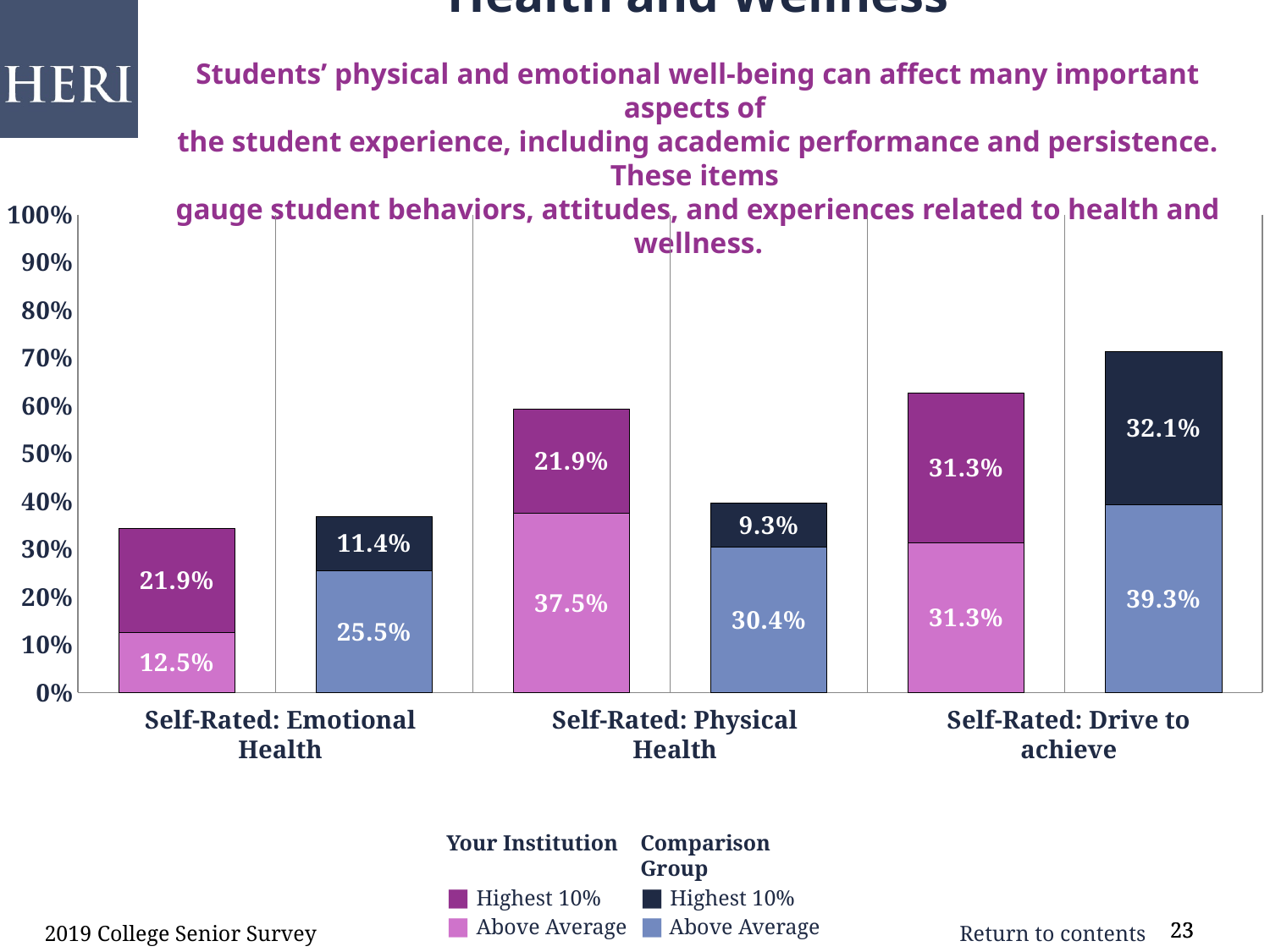
What is the total of the stacked bar for the Comparison Group on Self-Rated: Drive to achieve? 71.4% Which category has the tallest stacked bar for the Comparison Group? Self-Rated: Drive to achieve Is the total stacked bar for Your Institution on Self-Rated: Emotional Health greater or less than 40%? less How many entries does the legend list? 4 What is the "Highest 10%" value for Your Institution on Self-Rated: Drive to achieve? 31.3% What kind of chart is shown on the slide? Stacked bar chart What is the difference between the "Above Average" values for Your Institution and the Comparison Group on Self-Rated: Physical Health? 7.1% What is the "Highest 10%" value for the Comparison Group on Self-Rated: Physical Health? 9.3% What is the "Above Average" value for the Comparison Group on Self-Rated: Drive to achieve? 39.3% What is the "Above Average" value for Your Institution on Self-Rated: Emotional Health? 12.5% What is the total of the stacked bar for Your Institution on Self-Rated: Physical Health? 59.4% Which is larger on Self-Rated: Emotional Health, the "Highest 10%" value for Your Institution or for the Comparison Group? Your Institution